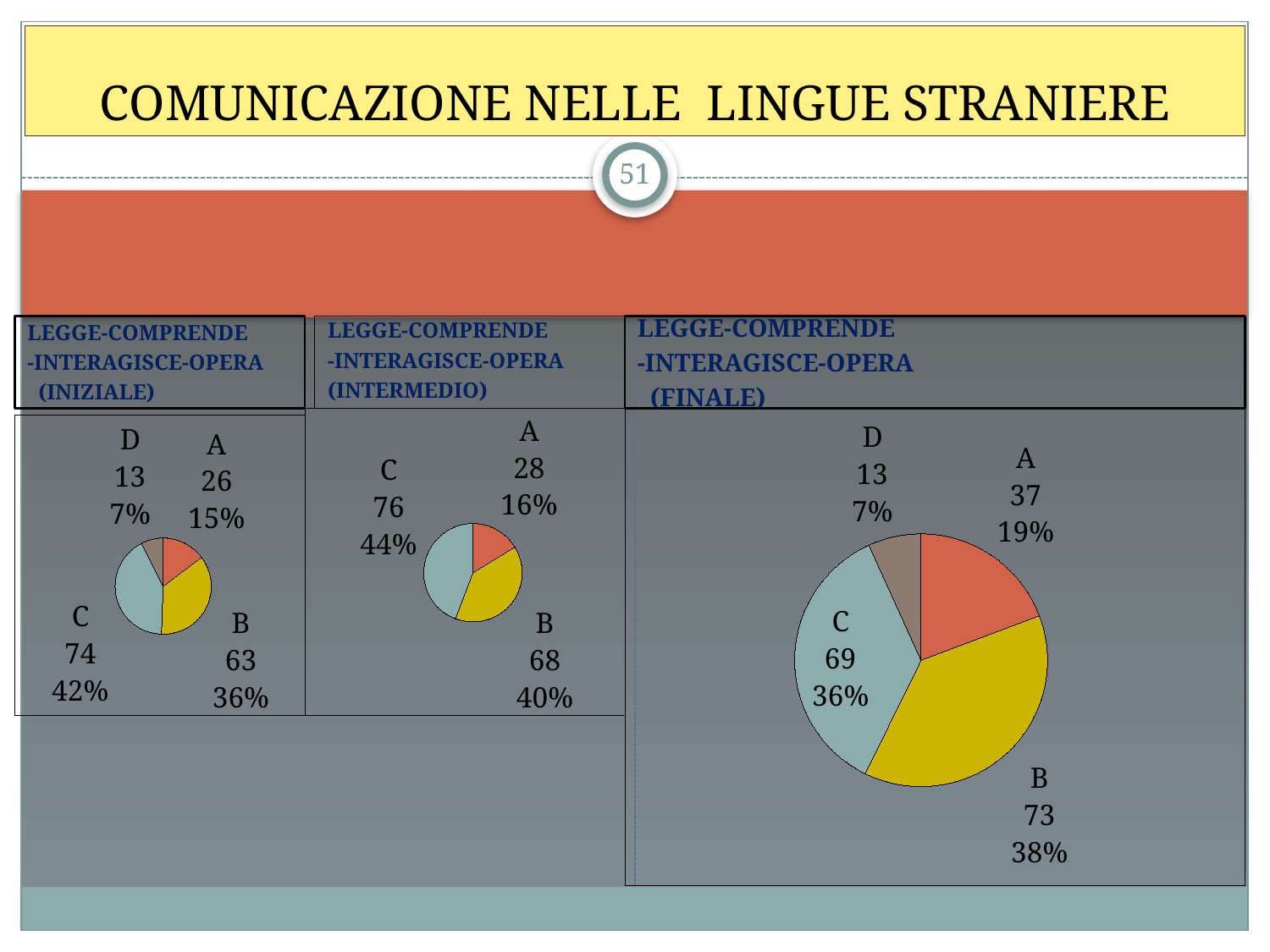
In the INTERMEDIO pie chart, what share of the pie does category A represent? 16% How many categories are shown in the FINALE pie chart? 4 In the FINALE pie chart, what is the value for category A? 37 What kind of chart is used on this slide? Pie chart In the FINALE pie chart, which is larger, the value for A or the value for D? A In the INTERMEDIO pie chart, what is the value for category B? 68 In the FINALE pie chart, what is the difference between the values for B and C? 4 In the INIZIALE pie chart, what share of the pie does category B represent? 36% In the INIZIALE pie chart, which category has the smallest value? D In the INTERMEDIO pie chart, which category has the largest value? C In the FINALE pie chart, which category has the largest value? B In the INIZIALE pie chart, what is the value for category C? 74